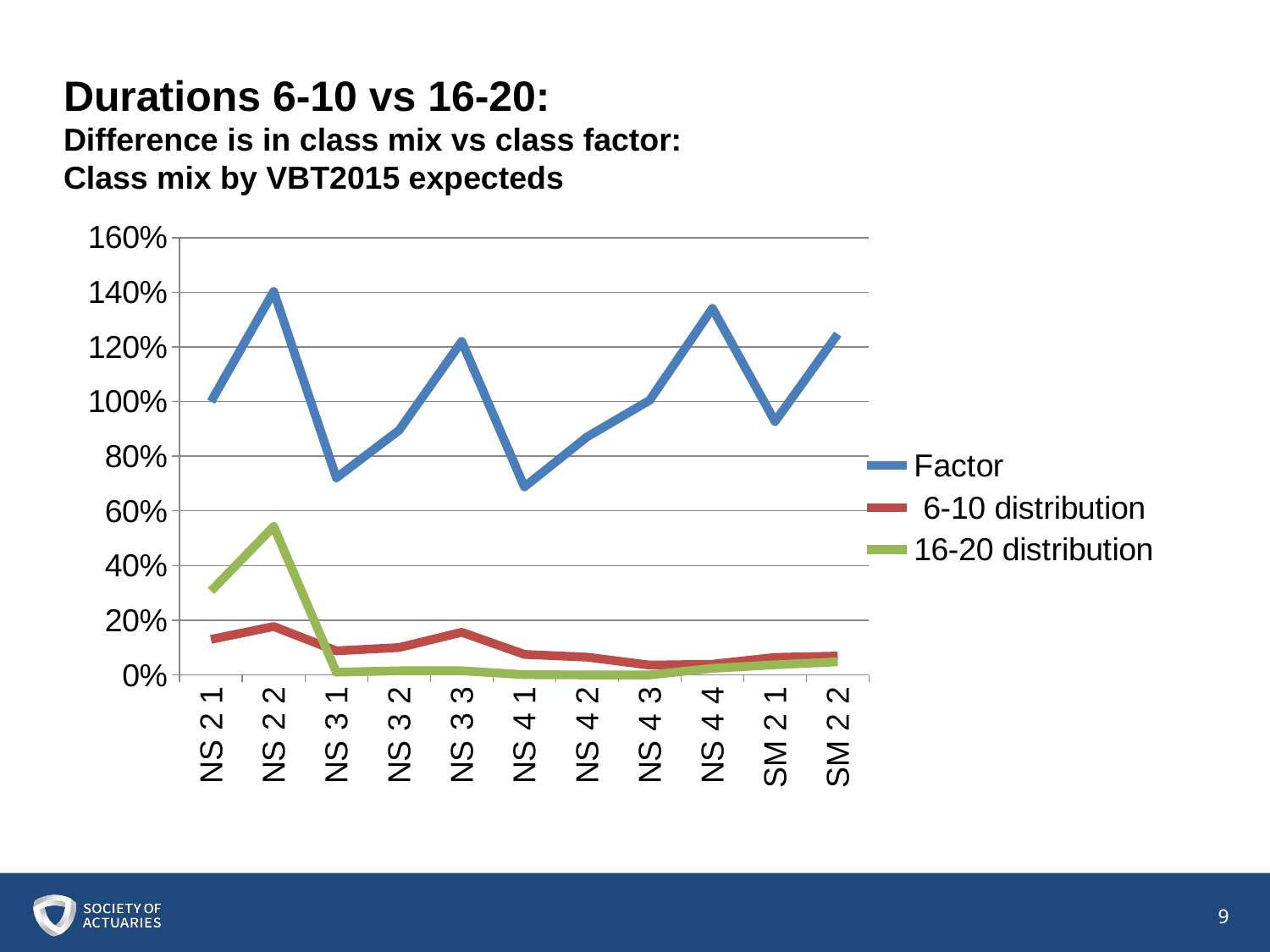
How many categories are shown on the x axis? 11 Which is larger at NS 3 1: the 6-10 distribution or the 16-20 distribution? 6-10 distribution Which category has the highest 16-20 distribution value? NS 2 2 Is the Factor value for NS 3 1 greater or less than 80%? less How many series does the legend list? 3 Is the Factor value for NS 4 4 greater or less than 120%? greater What kind of chart is shown on the slide? line chart Which is larger at NS 2 1: the 6-10 distribution or the 16-20 distribution? 16-20 distribution Is the 16-20 distribution value for NS 2 2 greater or less than 40%? greater What colour is the Factor line in the chart? blue Which category has the highest Factor value? NS 2 2